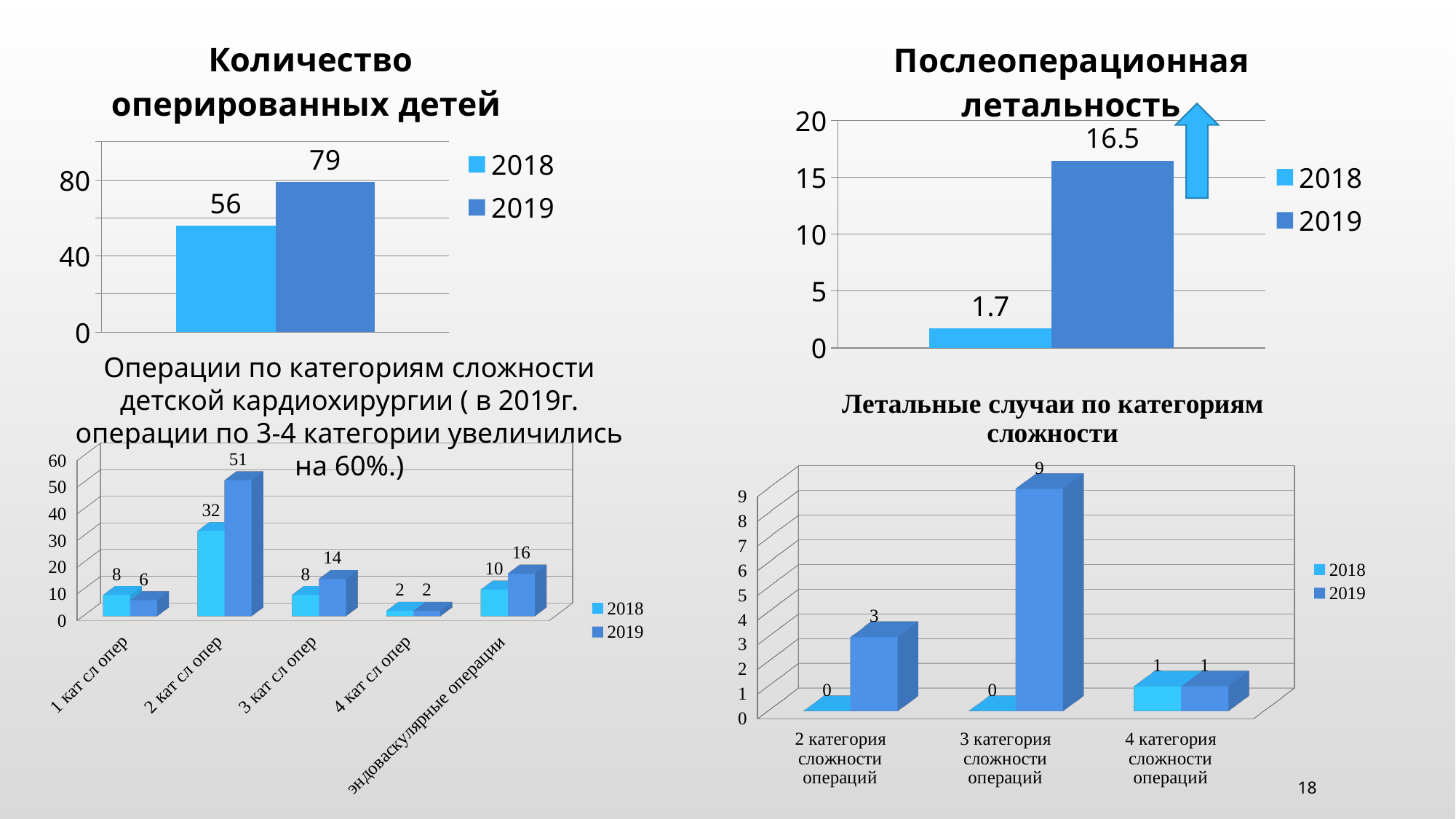
In the chart titled 'Послеоперационная летальность', what is the value for 2018? 1.7 In the chart titled 'Послеоперационная летальность', is the value for 2019 greater or less than 15? greater In the bottom-left chart 'Операции по категориям сложности детской кардиохирургии', which category has the lowest 2018 value? 4 кат сл опер What kind of chart is the one titled 'Летальные случаи по категориям сложности'? bar chart In the bottom-left chart 'Операции по категориям сложности детской кардиохирургии', what is the 2019 value for '2 кат сл опер'? 51 In the bottom-left chart 'Операции по категориям сложности детской кардиохирургии', what is the difference between the 2019 and 2018 values for 'эндоваскулярные операции'? 6 In the chart titled 'Количество оперированных детей', what is the difference between the 2019 and 2018 values? 23 In the chart titled 'Послеоперационная летальность', which year has the higher value? 2019 In the chart titled 'Летальные случаи по категориям сложности', how many series does the legend list? 2 In the chart titled 'Летальные случаи по категориям сложности', what is the 2019 value for '3 категория сложности операций'? 9 In the bottom-left chart 'Операции по категориям сложности детской кардиохирургии', how many categories are shown on the x axis? 5 In the chart titled 'Количество оперированных детей', what is the value for 2019? 79